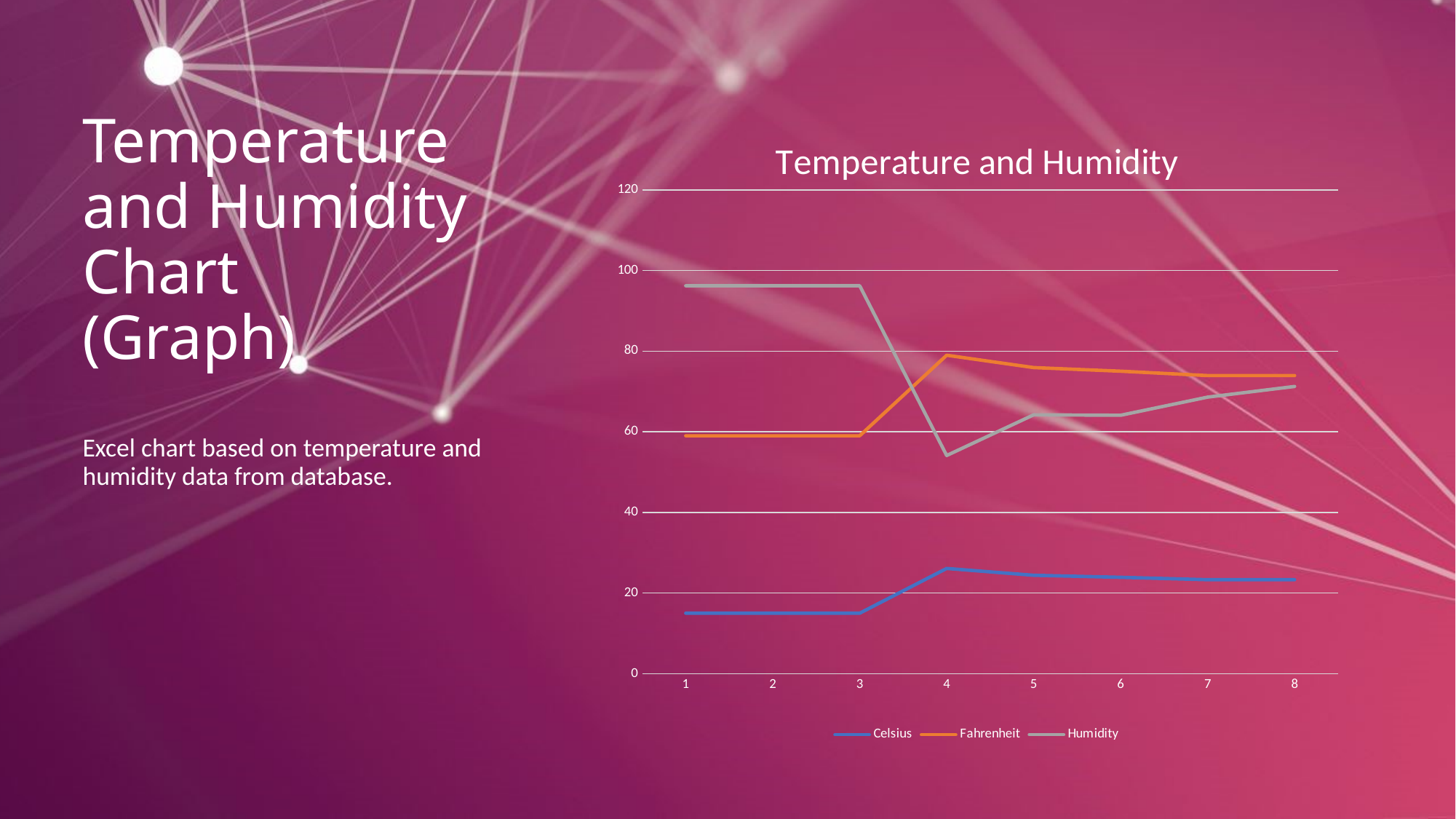
Is the Humidity value at point 1 greater or less than 80? greater Is the Humidity value at point 4 greater or less than 60? less How many points are plotted along the x axis for each series? 8 What kind of chart is shown on the slide? line chart How many series does the legend list? 3 At which point on the x axis is the Humidity series at its lowest? 4 At point 1, which is larger: Humidity or Fahrenheit? Humidity What is the title of the chart? Temperature and Humidity At point 4, which is larger: Fahrenheit or Humidity? Fahrenheit Is the Celsius value at point 4 greater or less than 20? greater Which series are listed in the legend? Celsius, Fahrenheit, Humidity